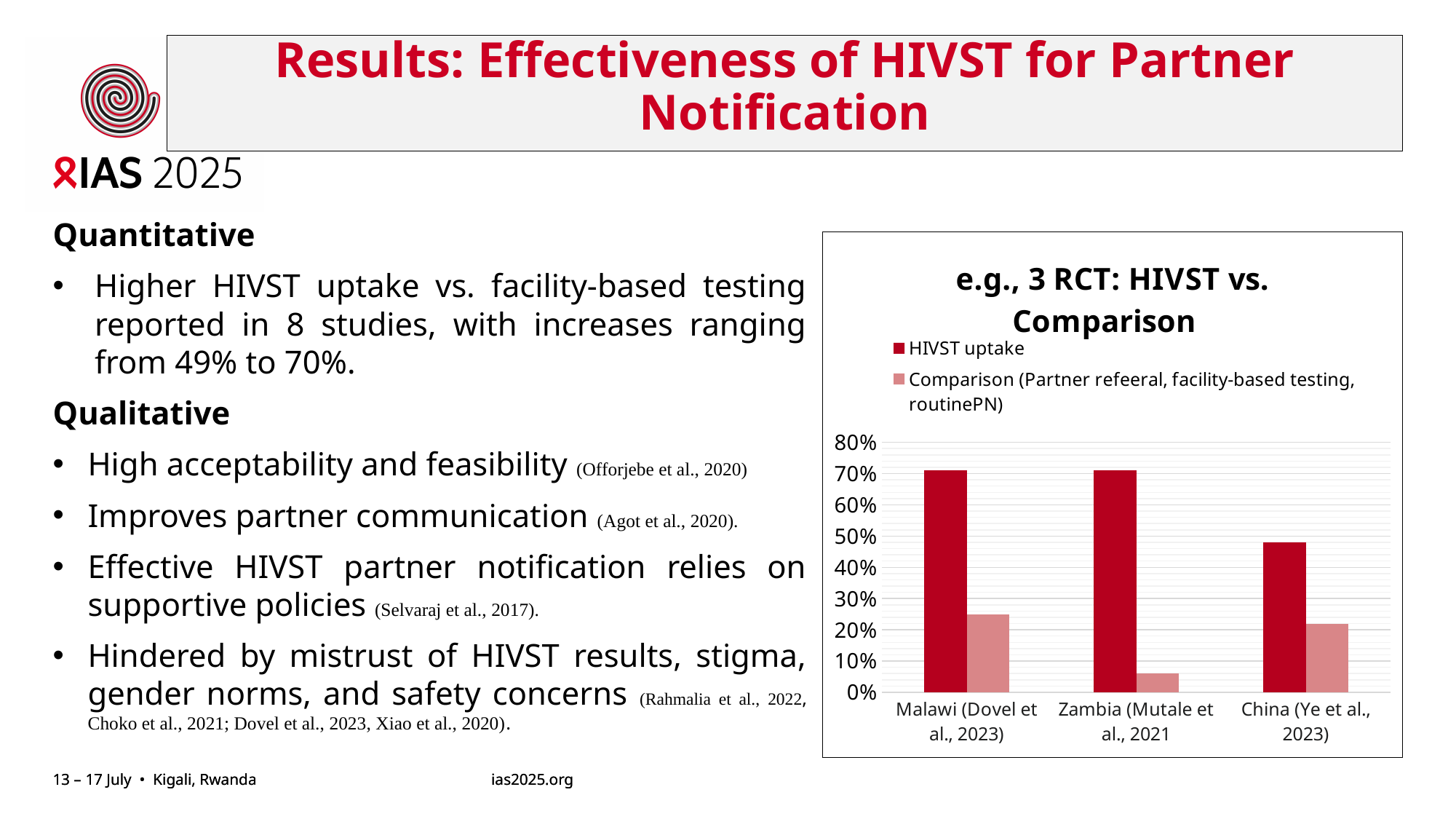
For Zambia (Mutale et al., 2021), which is larger: HIVST uptake or the Comparison value? HIVST uptake Is the HIVST uptake for Malawi (Dovel et al., 2023) greater or less than 60%? greater Is the HIVST uptake for China (Ye et al., 2023) greater or less than 40%? greater What is the title of the chart? e.g., 3 RCT: HIVST vs. Comparison Is the Comparison value for China (Ye et al., 2023) greater or less than 30%? less How many study categories are shown on the x axis of the chart? 3 Which is larger: the HIVST uptake for Malawi (Dovel et al., 2023) or the HIVST uptake for China (Ye et al., 2023)? Malawi (Dovel et al., 2023) How many series does the chart legend list? 2 What kind of chart is shown on the slide? bar chart Which study has the lowest HIVST uptake in the chart? China (Ye et al., 2023) Which study has the lowest Comparison value in the chart? Zambia (Mutale et al., 2021)